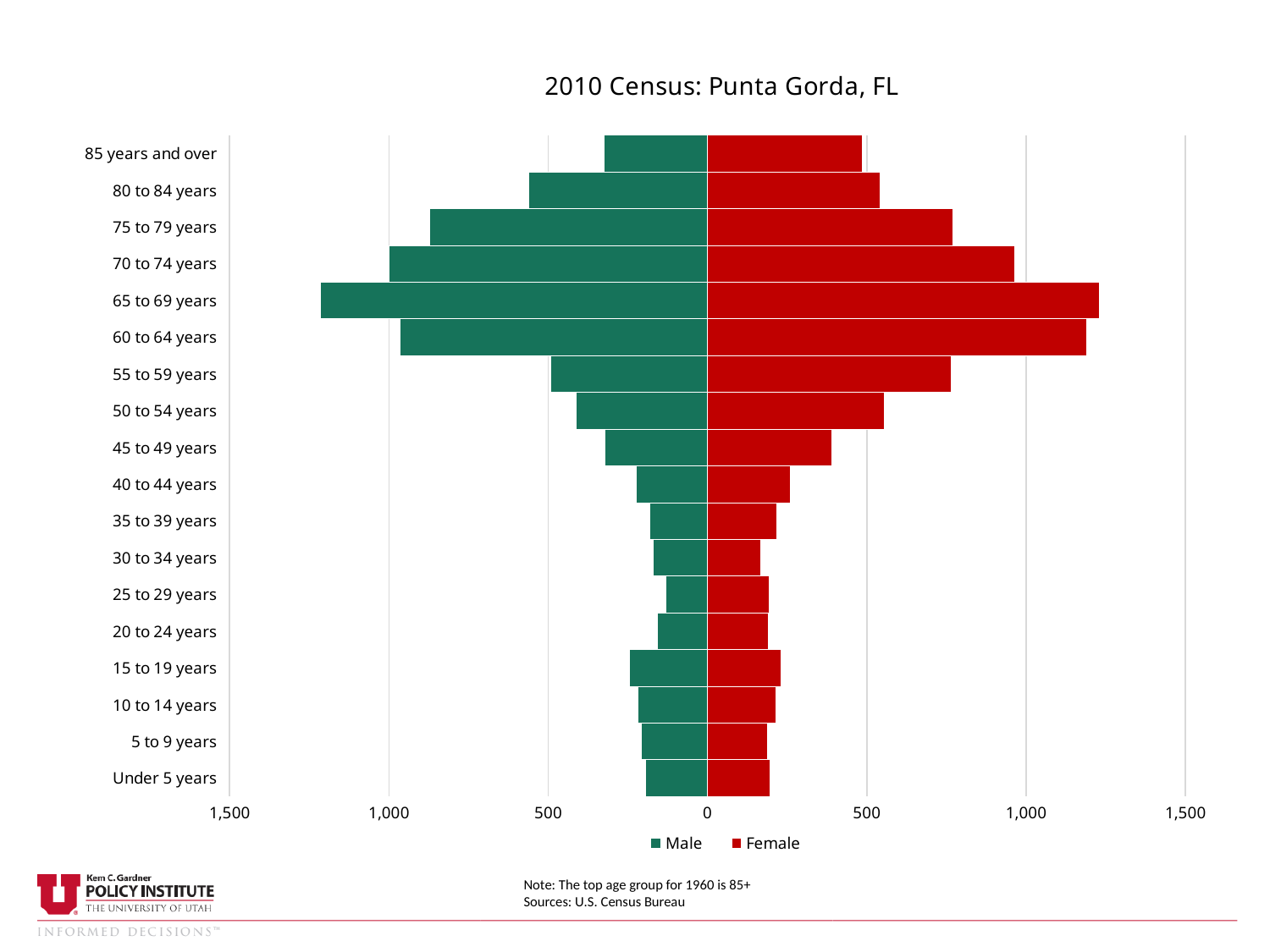
Is the Female value for 75 to 79 years greater or less than 500? greater Is the Male value for 85 years and over greater or less than 500? less What kind of chart is shown on the slide? bar chart How many age groups are shown on the chart? 18 Is the Female value for 60 to 64 years greater or less than 1,000? greater How many series does the legend list? 2 Which is larger, the Male value for 70 to 74 years or the Male value for 50 to 54 years? 70 to 74 years Which age group has the longest Male bar? 65 to 69 years What is the title of the chart? 2010 Census: Punta Gorda, FL Which colour represents Female in the chart? red